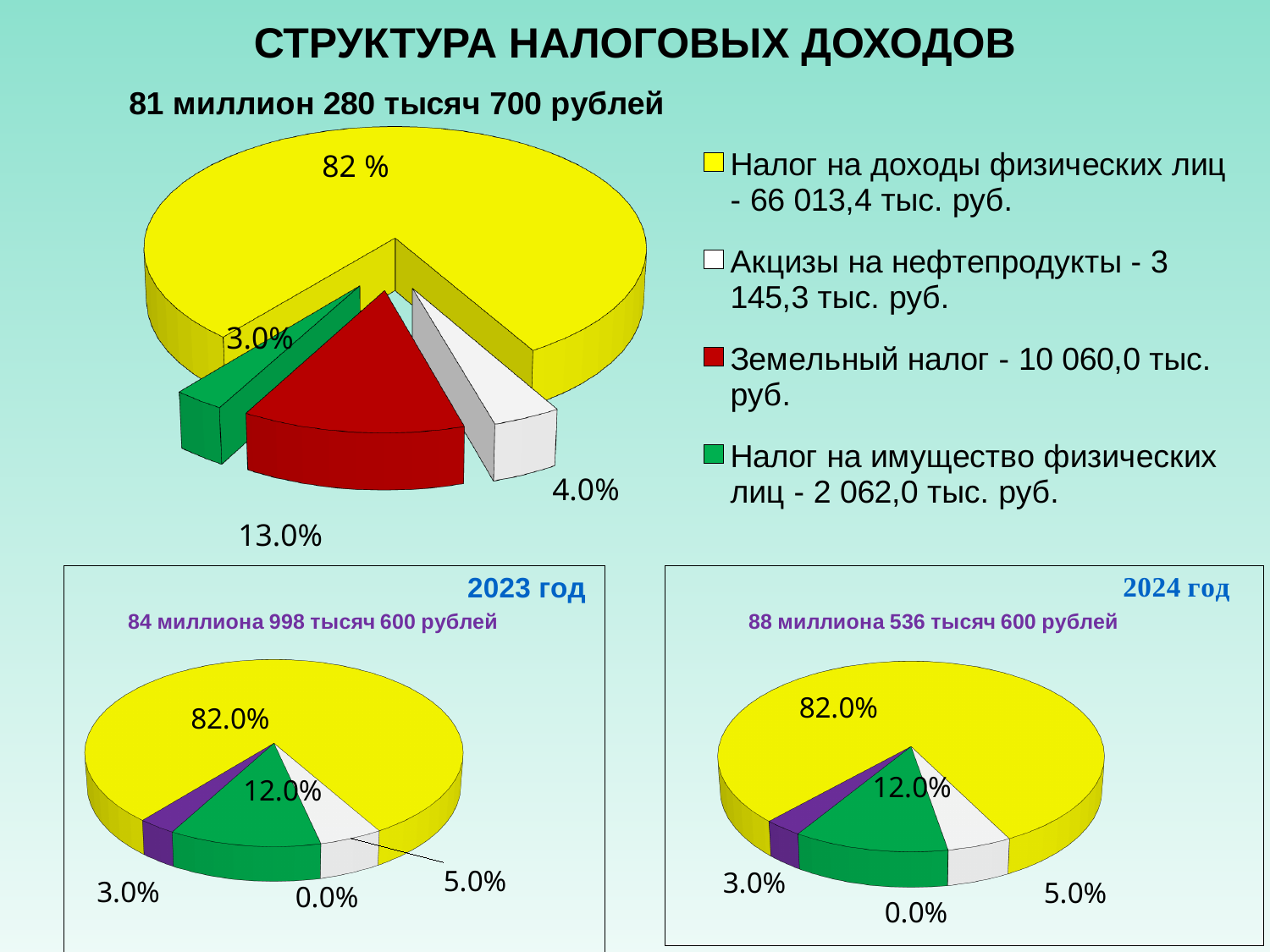
According to the legend of the top pie chart, what is the value for Земельный налог? 10 060,0 тыс. руб. In the top pie chart, which is larger: Земельный налог or Акцизы на нефтепродукты? Земельный налог In the top pie chart, what share is shown for the yellow slice (Налог на доходы физических лиц)? 82 % What kind of chart is the large chart at the top of the slide? pie chart What total amount is stated in the 2024 год chart? 88 миллиона 536 тысяч 600 рублей In the top pie chart, what share is shown for the red slice (Земельный налог)? 13.0% According to the legend of the top pie chart, what is the value for Налог на имущество физических лиц? 2 062,0 тыс. руб. How many categories does the legend of the top pie chart list? 4 In the top pie chart, which category has the smallest share? Налог на имущество физических лиц In the 2023 год pie chart, what is the share of the largest (yellow) slice? 82.0% What total amount is stated above the top pie chart? 81 миллион 280 тысяч 700 рублей